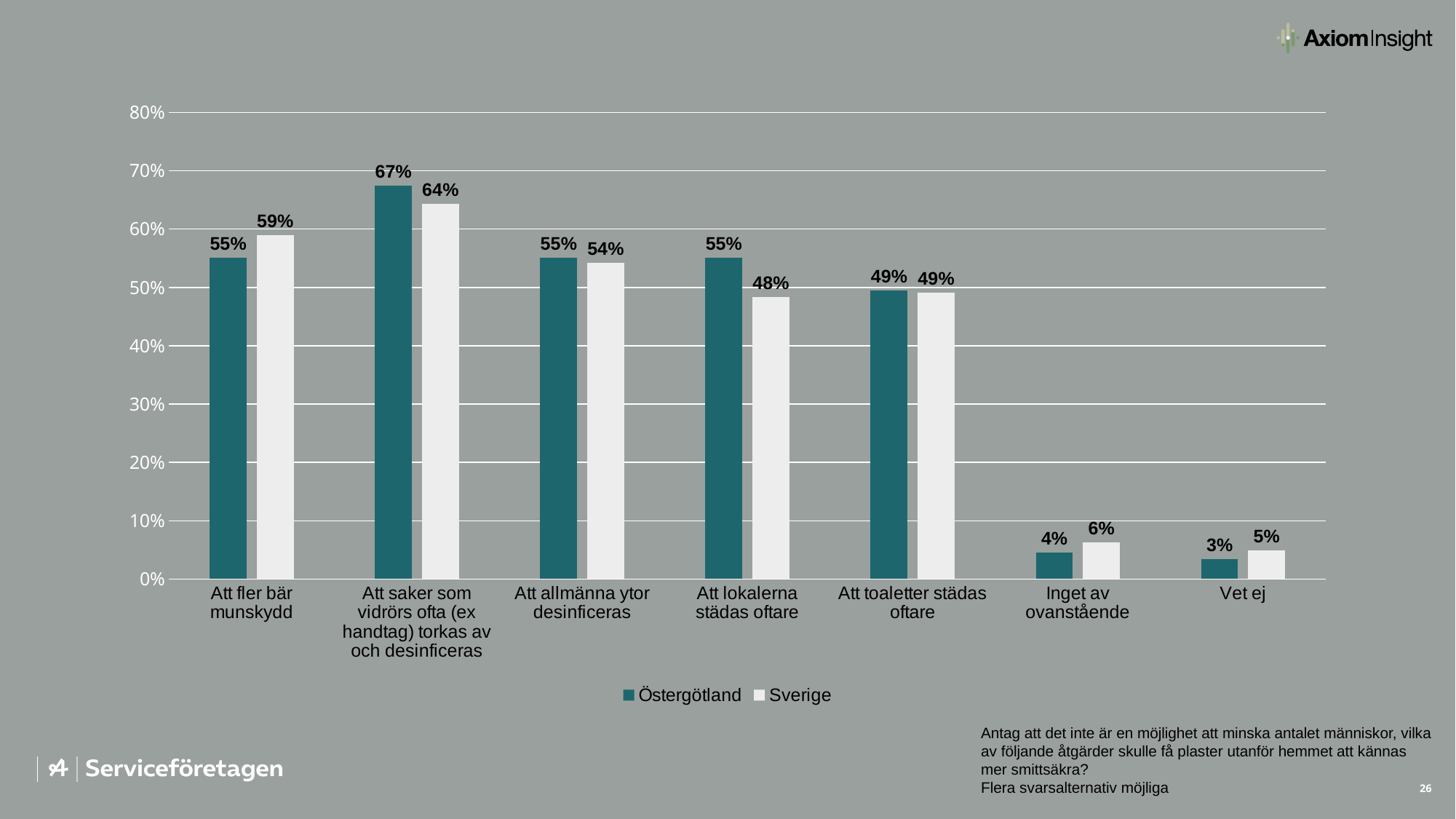
How many series does the legend list? 2 What is the value for Sverige for "Att lokalerna städas oftare"? 48% What is the value for Sverige for "Att saker som vidrörs ofta (ex handtag) torkas av och desinficeras"? 64% Which series is shown in dark teal in the legend? Östergötland What is the value for Östergötland for "Att fler bär munskydd"? 55% Which category has the highest value for Östergötland? Att saker som vidrörs ofta (ex handtag) torkas av och desinficeras Which category has the lowest value for Sverige? Vet ej How many categories are shown on the x axis? 7 What kind of chart is shown on the slide? bar chart Which is larger for "Att fler bär munskydd": the Östergötland value or the Sverige value? Sverige Is the Östergötland value for "Att toaletter städas oftare" greater or less than 60%? less What is the difference between the Östergötland and Sverige values for "Att lokalerna städas oftare"? 7%